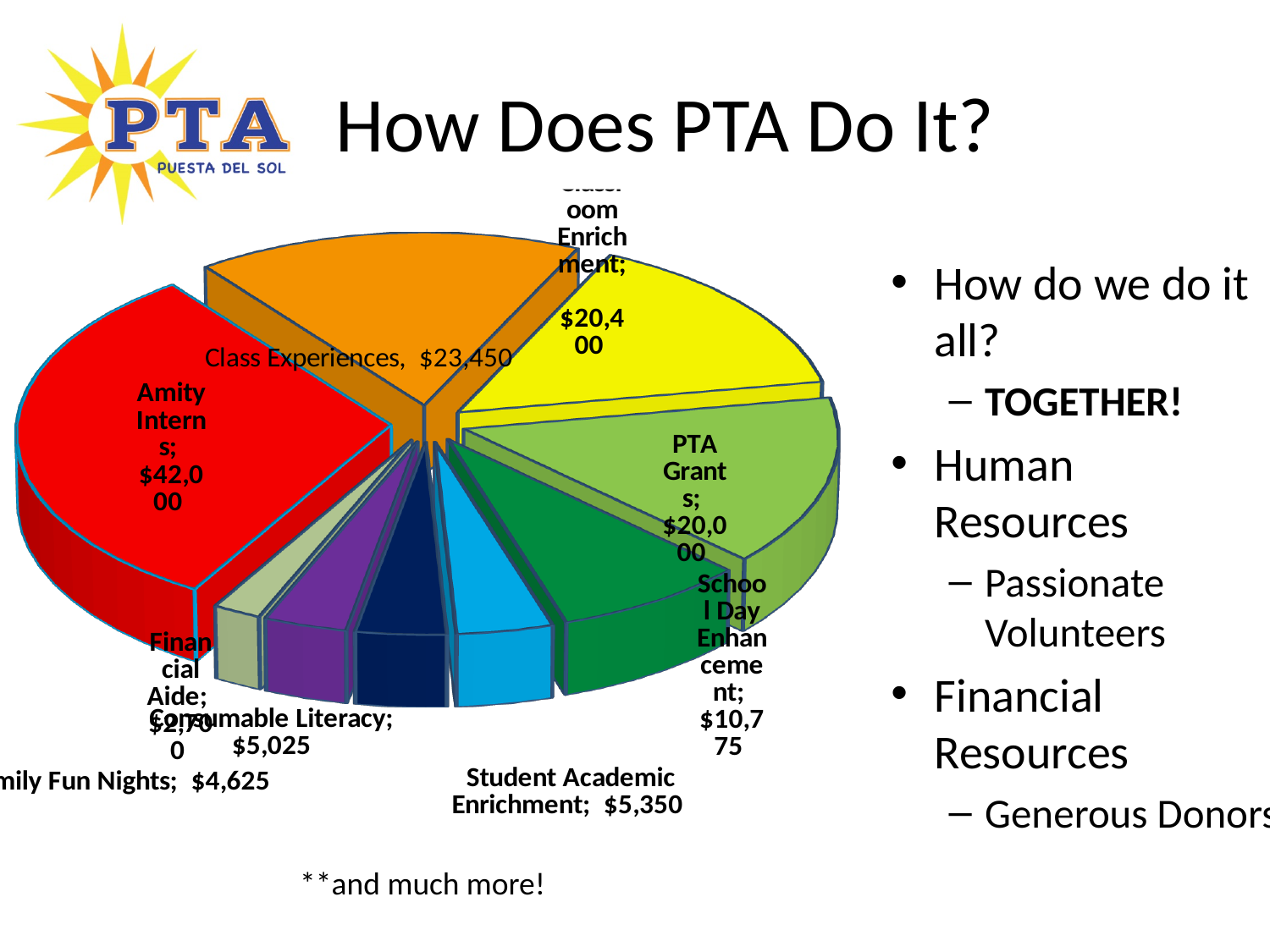
What is the value for School Day Enhancement in the pie chart? $10,775 Which category has the largest slice in the pie chart? Amity Interns What is the value for Amity Interns in the pie chart? $42,000 What colour is the Amity Interns slice in the pie chart? Red What is the value for Student Academic Enrichment in the pie chart? $5,350 Which is larger, PTA Grants or School Day Enhancement? PTA Grants What is the value for Class Experiences in the pie chart? $23,450 What kind of chart is shown on the slide? Pie chart What is the value for Consumable Literacy in the pie chart? $5,025 What is the value for PTA Grants in the pie chart? $20,000 What is the difference between the values for Class Experiences and PTA Grants? $3,450 What is the difference between the values for Amity Interns and Class Experiences? $18,550